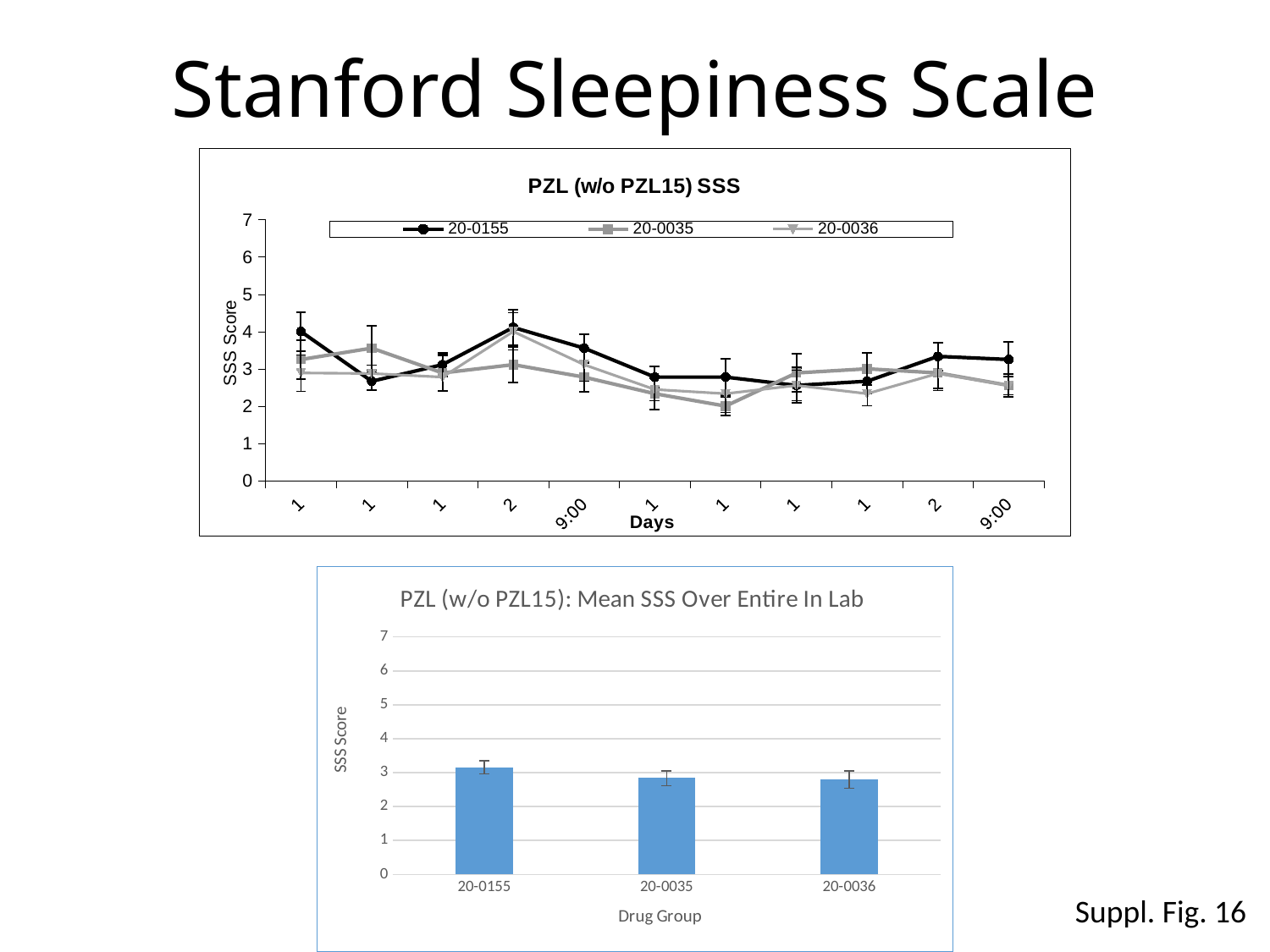
In the top chart "PZL (w/o PZL15) SSS", what are the three series named in the legend? 20-0155, 20-0035, 20-0036 In the bottom chart "PZL (w/o PZL15): Mean SSS Over Entire In Lab", is the value for 20-0035 greater or less than 3? less In the bottom chart "PZL (w/o PZL15): Mean SSS Over Entire In Lab", which drug group has the highest mean SSS score? 20-0155 In the bottom chart "PZL (w/o PZL15): Mean SSS Over Entire In Lab", is the value for 20-0155 greater or less than 3? greater In the top chart "PZL (w/o PZL15) SSS", how many series does the legend list? 3 What kind of chart is the top chart titled "PZL (w/o PZL15) SSS"? line chart In the top chart "PZL (w/o PZL15) SSS", what is the x-axis title? Days In the bottom chart "PZL (w/o PZL15): Mean SSS Over Entire In Lab", is the value for 20-0036 greater or less than 3? less In the bottom chart "PZL (w/o PZL15): Mean SSS Over Entire In Lab", which is larger, the value for 20-0155 or the value for 20-0036? 20-0155 In the top chart "PZL (w/o PZL15) SSS", what is the highest value shown on the y axis? 7 What kind of chart is the bottom chart titled "PZL (w/o PZL15): Mean SSS Over Entire In Lab"? bar chart In the bottom chart "PZL (w/o PZL15): Mean SSS Over Entire In Lab", how many drug groups are shown on the x axis? 3